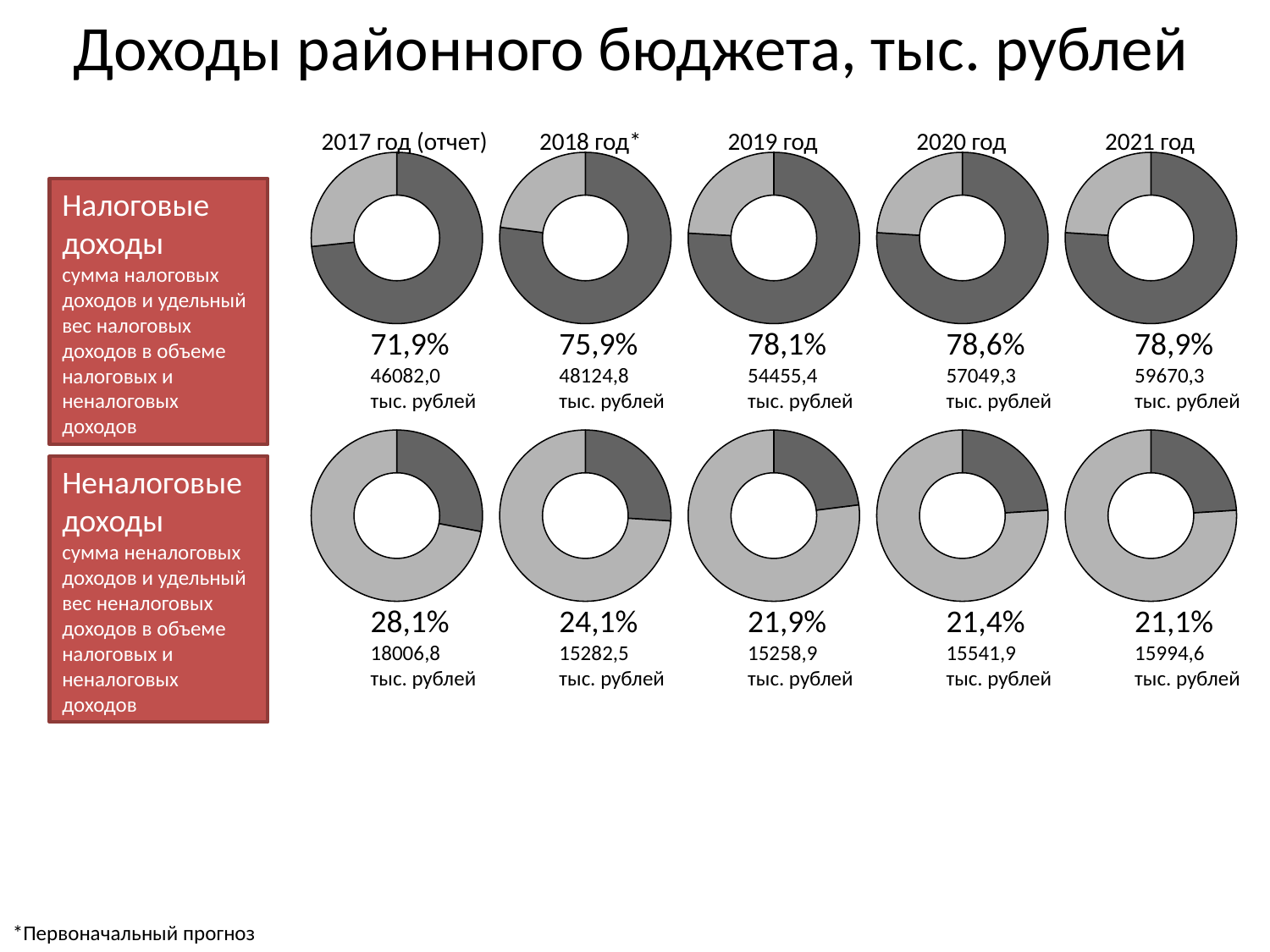
In the top-row donut chart for 2019 год, what is the amount of tax revenues shown below the chart? 54455,4 тыс. рублей Across the bottom-row donut charts (Неналоговые доходы), which year has the lowest share of non-tax revenues? 2021 год Across the top-row donut charts (Налоговые доходы), which year has the highest share of tax revenues? 2021 год In the bottom-row donut chart for 2018 год*, what is the amount of non-tax revenues shown below the chart? 15282,5 тыс. рублей In the bottom-row donut chart for 2021 год, what share do non-tax revenues (Неналоговые доходы) make up? 21,1% What is the difference between the tax revenue amounts in the top-row charts for 2018 год* and 2017 год (отчет)? 2042,8 тыс. рублей In the top-row donut chart for 2017 год (отчет), what share do tax revenues (Налоговые доходы) make up? 71,9% Looking at the top-row charts from 2017 to 2021, does the share of tax revenues rise or fall over the years? rises By how many percentage points is the tax revenue share in the 2021 год top-row chart higher than in the 2017 год (отчет) top-row chart? 7,0 What kind of chart is used on this slide to show the revenue shares? pie chart (donut) Comparing the bottom-row charts, is the non-tax revenue amount larger in 2017 год (отчет) or in 2021 год? 2017 год (отчет) How many donut charts are shown on the slide in total? 10